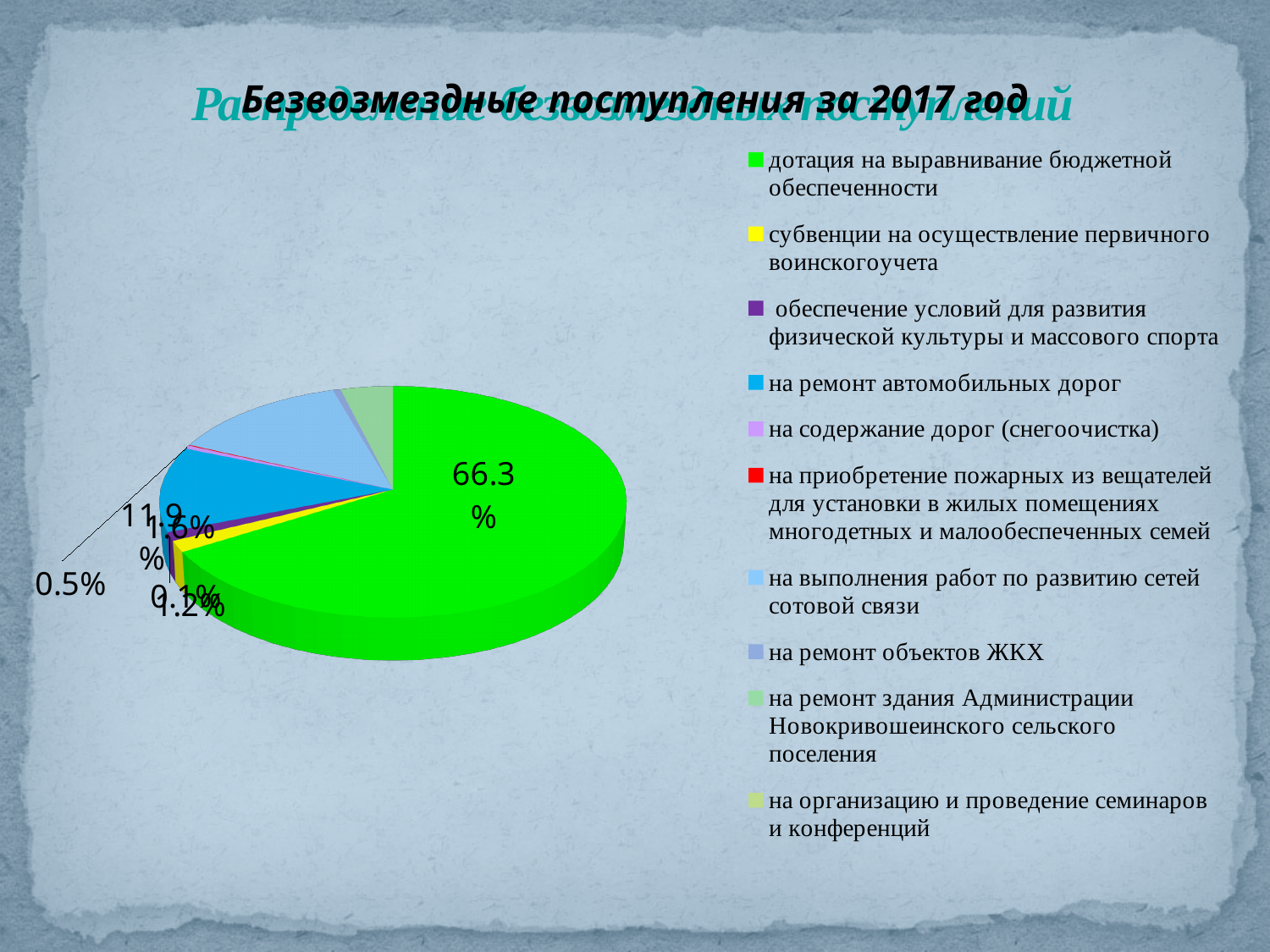
How many categories does the legend of the pie chart list? 10 Is the share for дотация на выравнивание бюджетной обеспеченности greater or less than 50%? greater Which category has the largest slice of the pie? дотация на выравнивание бюджетной обеспеченности What colour is the slice for дотация на выравнивание бюджетной обеспеченности? green What kind of chart is shown on the slide? pie chart What is the data label shown on the largest (green) slice of the pie? 66.3% What share of the pie is labelled for дотация на выравнивание бюджетной обеспеченности? 66.3% Which is larger: the slice for дотация на выравнивание бюджетной обеспеченности or the slice for на ремонт автомобильных дорог? дотация на выравнивание бюджетной обеспеченности What is the title of the chart in bold on the slide? Безвозмездные поступления за 2017 год